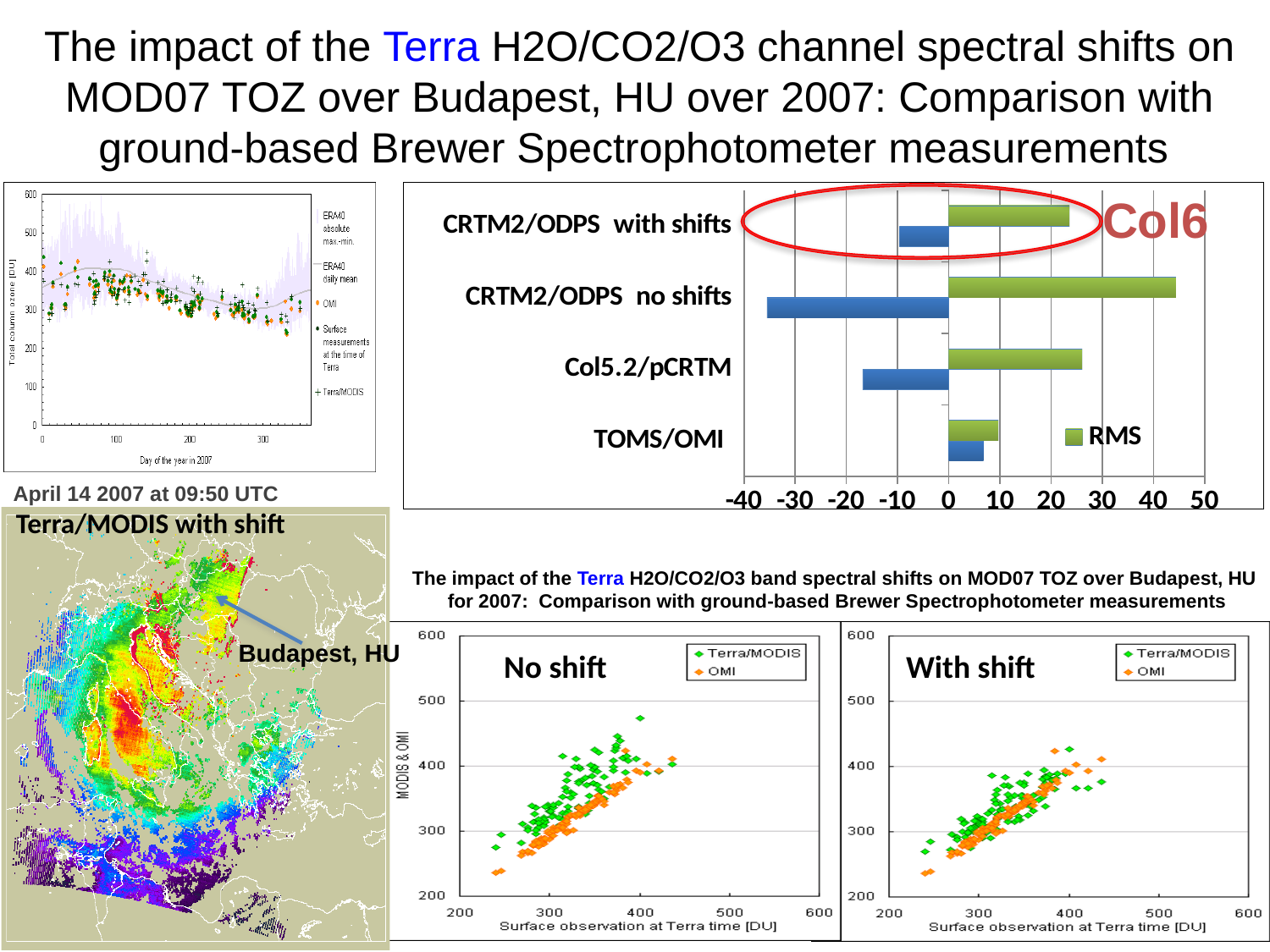
In the horizontal bar chart at the top right, is the blue bar value for CRTM2/ODPS no shifts greater or less than -30? less In the horizontal bar chart at the top right, what kind of chart is it? bar chart In the horizontal bar chart at the top right, is the green RMS value for TOMS/OMI greater or less than 20? less In the horizontal bar chart at the top right, is the green RMS bar for CRTM2/ODPS no shifts longer or shorter than the green RMS bar for CRTM2/ODPS with shifts? longer In the scatter plot labelled 'With shift' at the bottom, what is the label of the x axis? Surface observation at Terra time [DU] In the scatter plot labelled 'No shift' at the bottom, how many series does the legend list? 2 In the horizontal bar chart at the top right, which category has the longest green RMS bar? CRTM2/ODPS no shifts In the horizontal bar chart at the top right, how many categories are shown on the vertical axis? 4 In the horizontal bar chart at the top right, which series name appears in the legend? RMS In the horizontal bar chart at the top right, is the green RMS value for CRTM2/ODPS no shifts greater or less than 40? greater In the horizontal bar chart at the top right, which category has the shortest green RMS bar? TOMS/OMI In the horizontal bar chart at the top right, which category has the blue bar extending furthest into negative values? CRTM2/ODPS no shifts